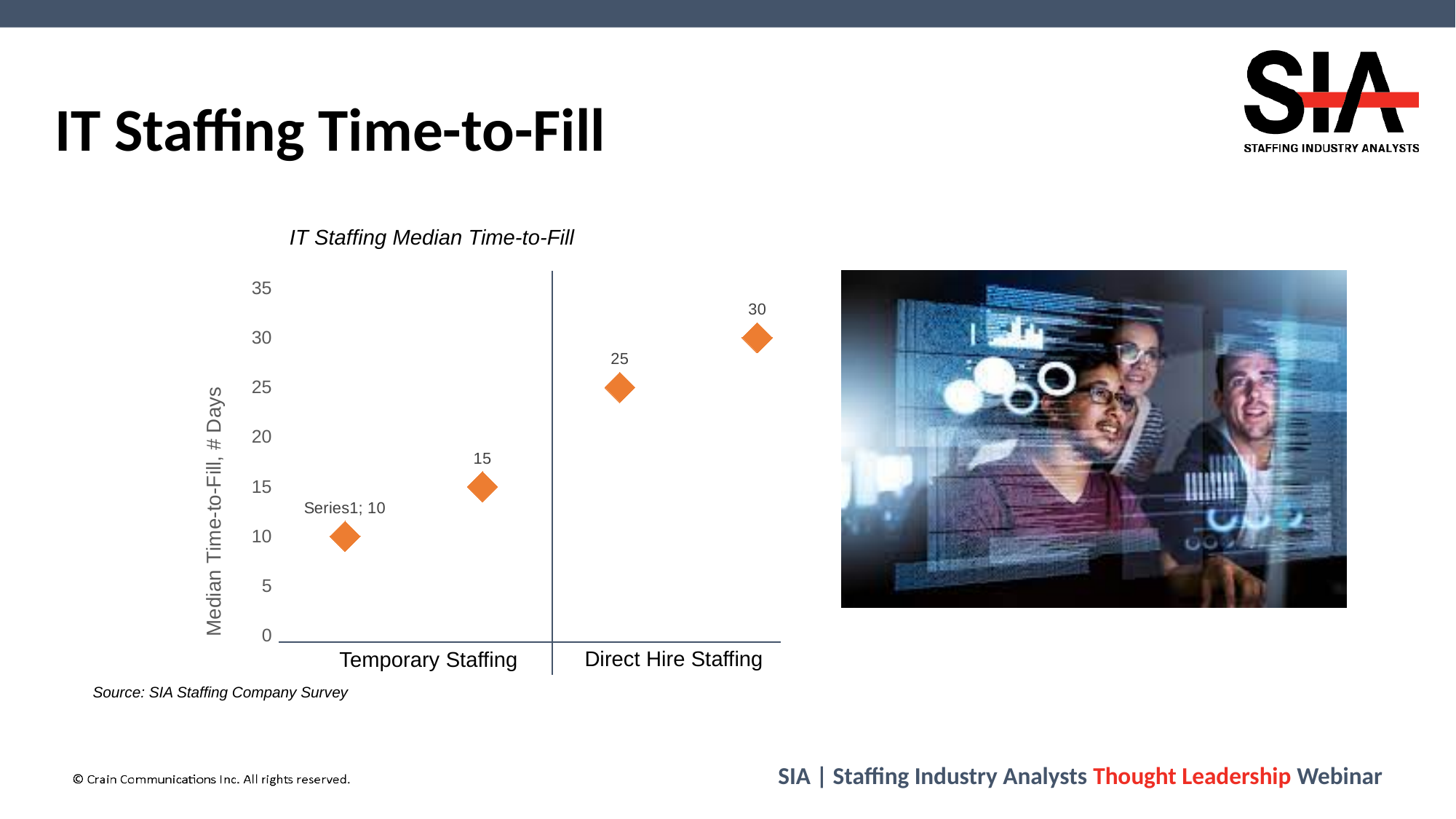
How many data points are plotted on the chart? 4 What are the two values plotted under Temporary Staffing? 10 and 15 Do the plotted values rise or fall from left to right across the chart? rise Which category group contains the lowest plotted value, Temporary Staffing or Direct Hire Staffing? Temporary Staffing What is the difference between the highest and lowest values plotted on the chart? 20 Which category group contains the highest plotted value, Temporary Staffing or Direct Hire Staffing? Direct Hire Staffing What is the label of the vertical axis of the chart? Median Time-to-Fill, # Days What is the title of the chart on the slide? IT Staffing Median Time-to-Fill What is the difference between the two values plotted under Direct Hire Staffing? 5 What is the highest value plotted on the chart? 30 What is the lowest value plotted on the chart? 10 What are the two values plotted under Direct Hire Staffing? 25 and 30